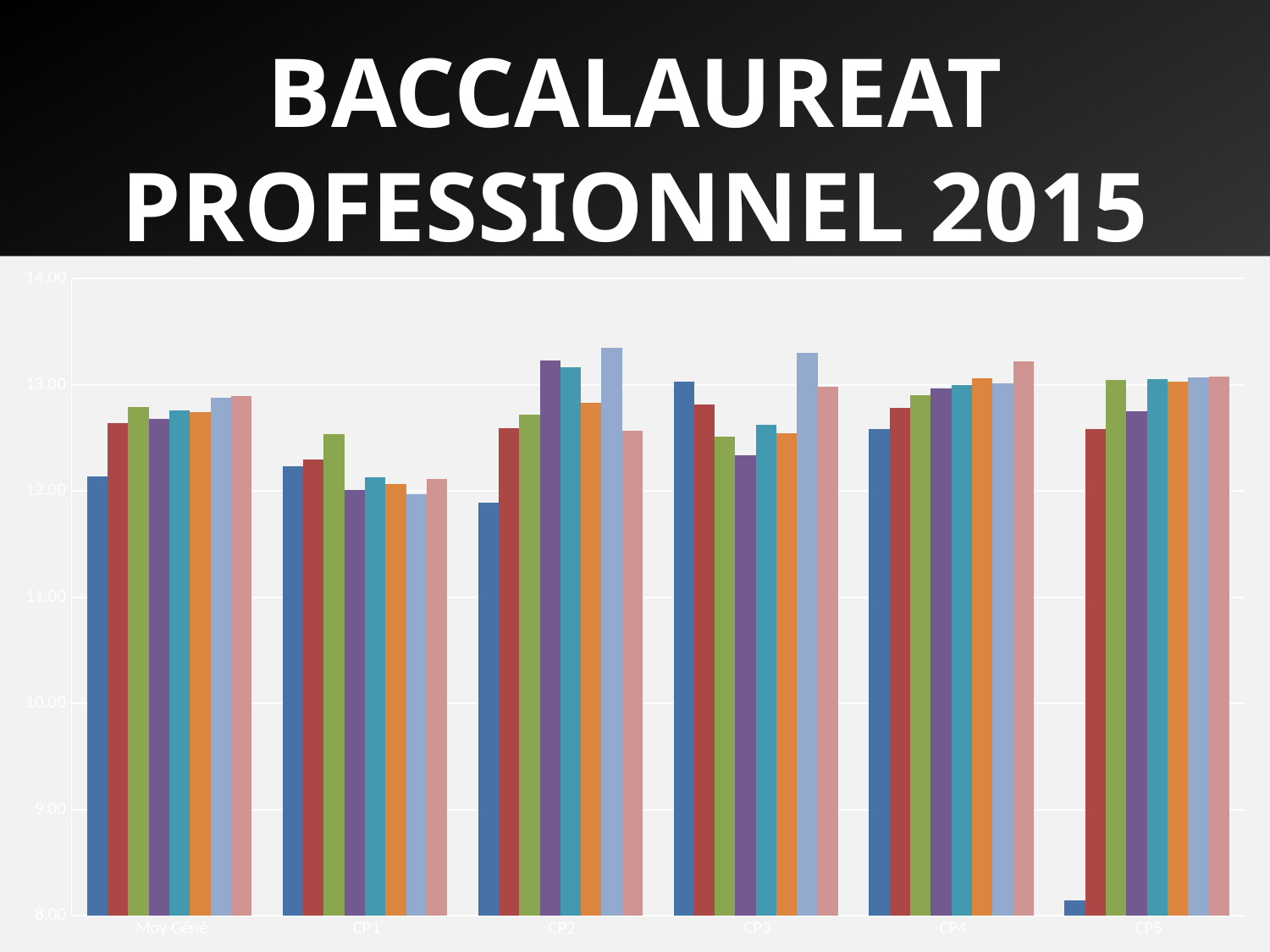
Is the value of the light blue (seventh) bar for CP3 greater or less than 13.00? greater Is the value of the dark blue (first) bar for CP5 greater or less than 9.00? less Is the value of the light blue (seventh) bar for CP2 greater or less than 13.00? greater How many bars are plotted for each category in the chart? 8 How many categories are shown on the x axis of the chart? 6 What is the highest tick value shown on the y axis of the chart? 14.00 What kind of chart is shown on the slide? bar chart What is the title shown above the chart? BACCALAUREAT PROFESSIONNEL 2015 Which category has the taller dark blue (first) bar, CP4 or CP5? CP4